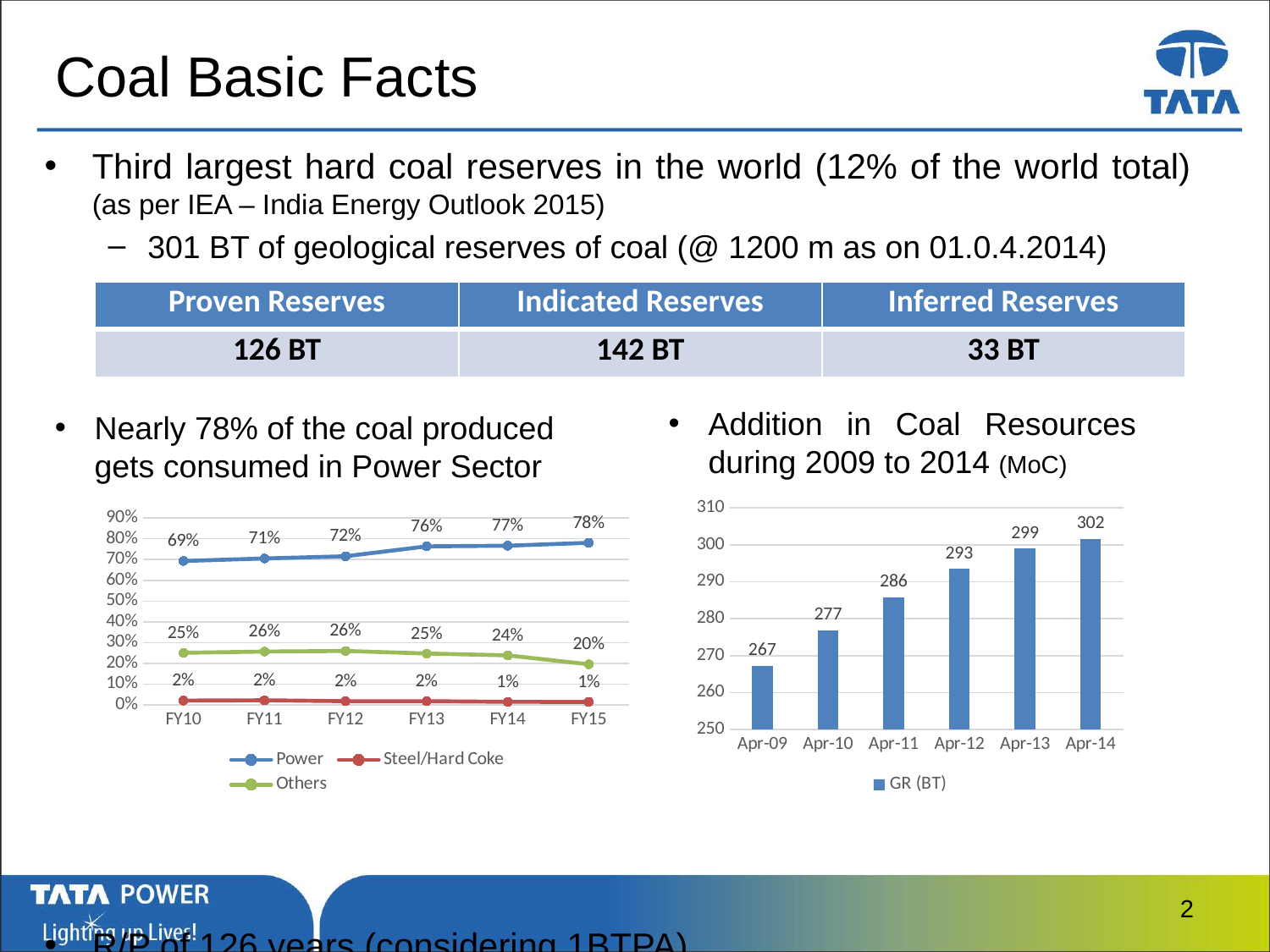
In the left line chart, what is the difference between the Power value in FY15 and the Power value in FY10? 9% In the left line chart, what is the value for Steel/Hard Coke in FY14? 1% In the left line chart, which series has the lowest value in FY12? Steel/Hard Coke What kind of chart is the right chart titled 'Addition in Coal Resources during 2009 to 2014'? bar chart In the right chart titled 'Addition in Coal Resources during 2009 to 2014', how many categories are shown on the x axis? 6 In the right chart titled 'Addition in Coal Resources during 2009 to 2014', what is the difference between the Apr-14 value and the Apr-09 value? 35 In the right chart titled 'Addition in Coal Resources during 2009 to 2014', which category has the highest value? Apr-14 In the left line chart, what is the value for Others in FY15? 20% In the left line chart, what is the value for Power in FY13? 76% In the left line chart, does the Power series rise or fall from FY10 to FY15? rise In the right chart titled 'Addition in Coal Resources during 2009 to 2014', what is the value for Apr-11? 286 In the left line chart, how many series does the legend list? 3